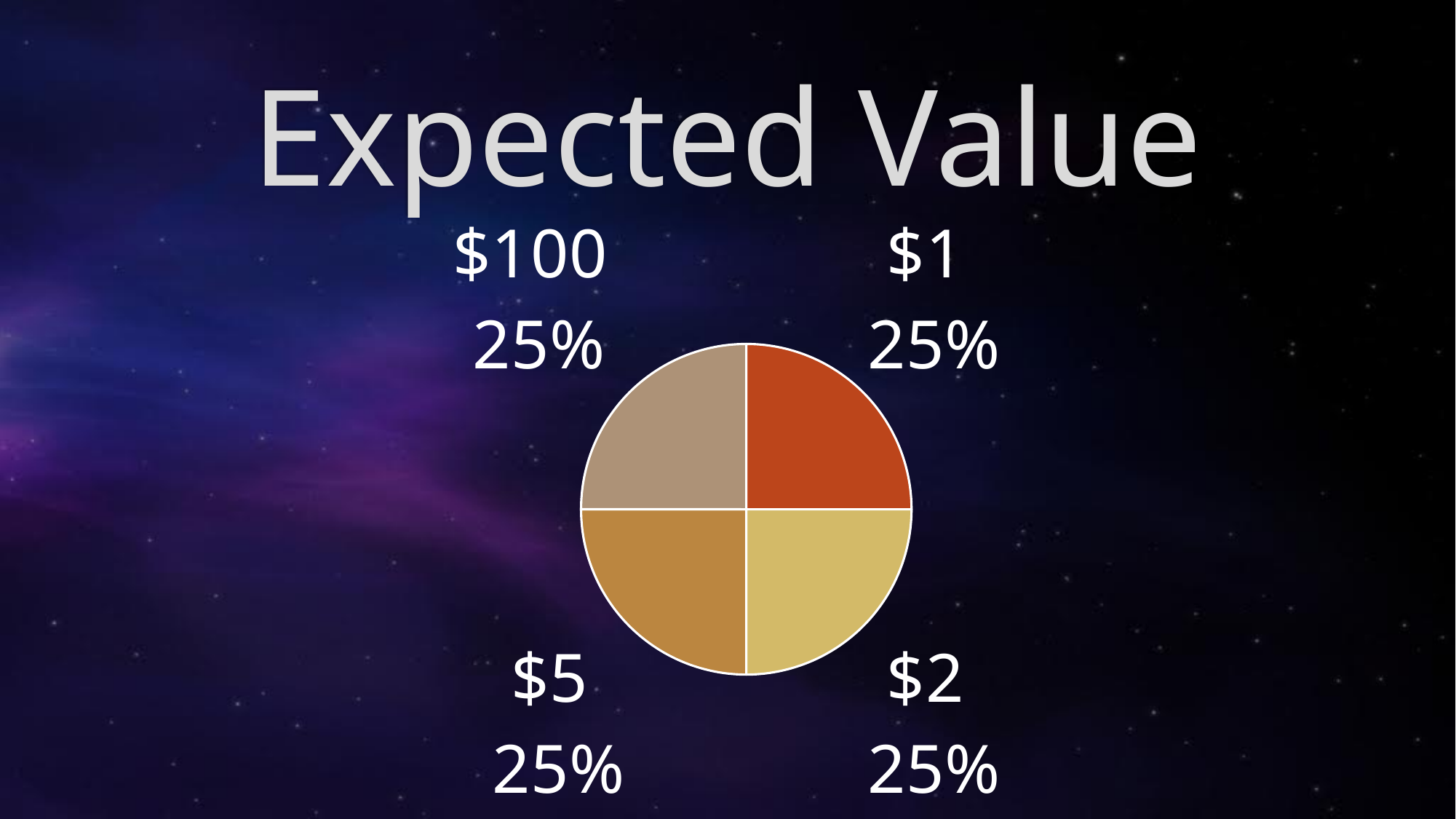
What is the difference between the share of the $100 slice and the share of the $2 slice? 0% What is the title of the slide containing the pie chart? Expected Value What share of the pie does the $2 slice represent? 25% Is the share of the $1 slice greater or less than 50%? less What share of the pie does the $100 slice represent? 25% What kind of chart is shown on the slide? pie chart What share of the pie does the $5 slice represent? 25% How many slices does the pie chart have? 4 Which dollar amount is labelled next to the red-orange slice in the top right of the pie? $1 What is the combined share of the $100 and $5 slices? 50%